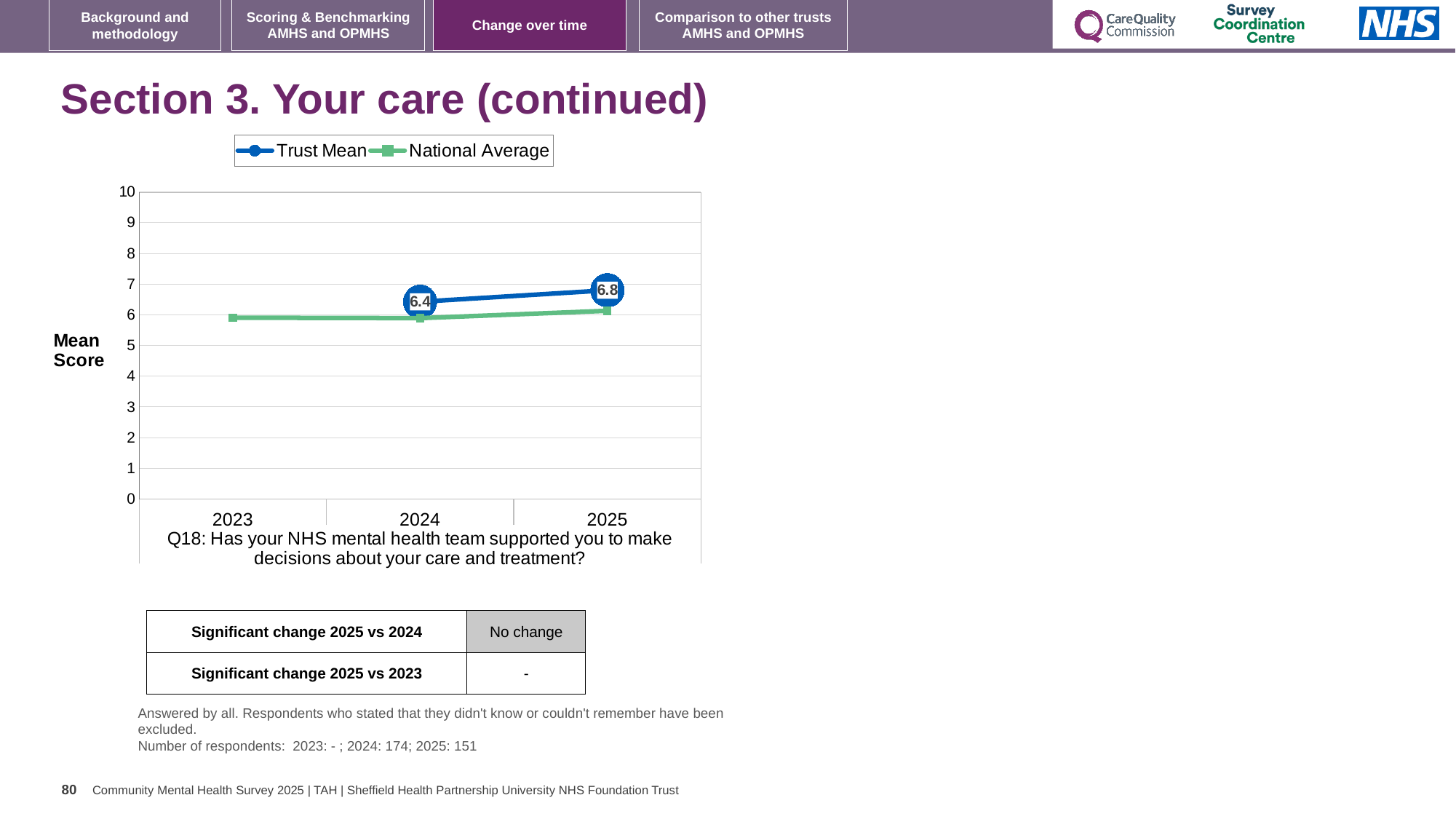
Is the National Average value for 2025 greater or less than 7? less By how much did the Trust Mean change from 2024 to 2025? 0.4 What is the Trust Mean value for 2024? 6.4 How many years are shown on the x axis? 3 What is the Trust Mean value for 2025? 6.8 In which year is the Trust Mean higher, 2024 or 2025? 2025 Does the Trust Mean rise or fall from 2024 to 2025? rise In 2025, which series has the higher value, Trust Mean or National Average? Trust Mean What kind of chart is shown on the slide? line chart How many series does the legend list? 2 What is the label on the y axis? Mean Score Is the National Average value for 2023 greater or less than 7? less